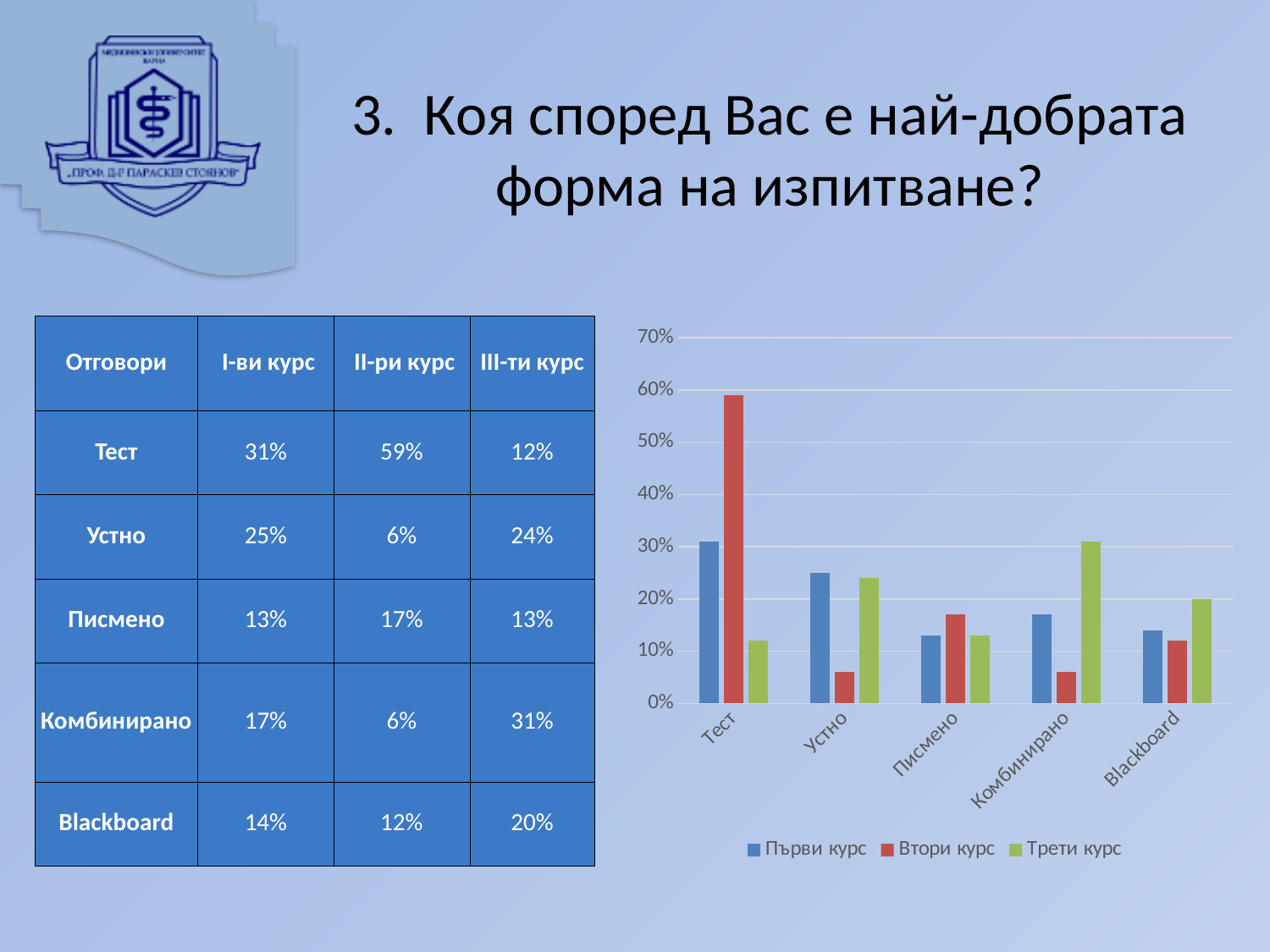
How many series does the chart legend list? 3 For the category Blackboard, which series has the larger value: Първи курс or Трети курс? Трети курс What kind of chart is shown on the slide? bar chart Which category has the highest value for Трети курс? Комбинирано Which category has the highest value for Втори курс? Тест What is the value for Комбинирано in the Трети курс series? 31% How many categories are shown on the x axis of the chart? 5 Which category has the lowest value for Първи курс? Писмено Is the value for Устно in the Втори курс series greater or less than 10%? less Is the value for Тест in the Втори курс series greater or less than 50%? greater What is the value for Тест in the Втори курс series? 59% What is the difference between the Втори курс and Първи курс values for Тест? 28%